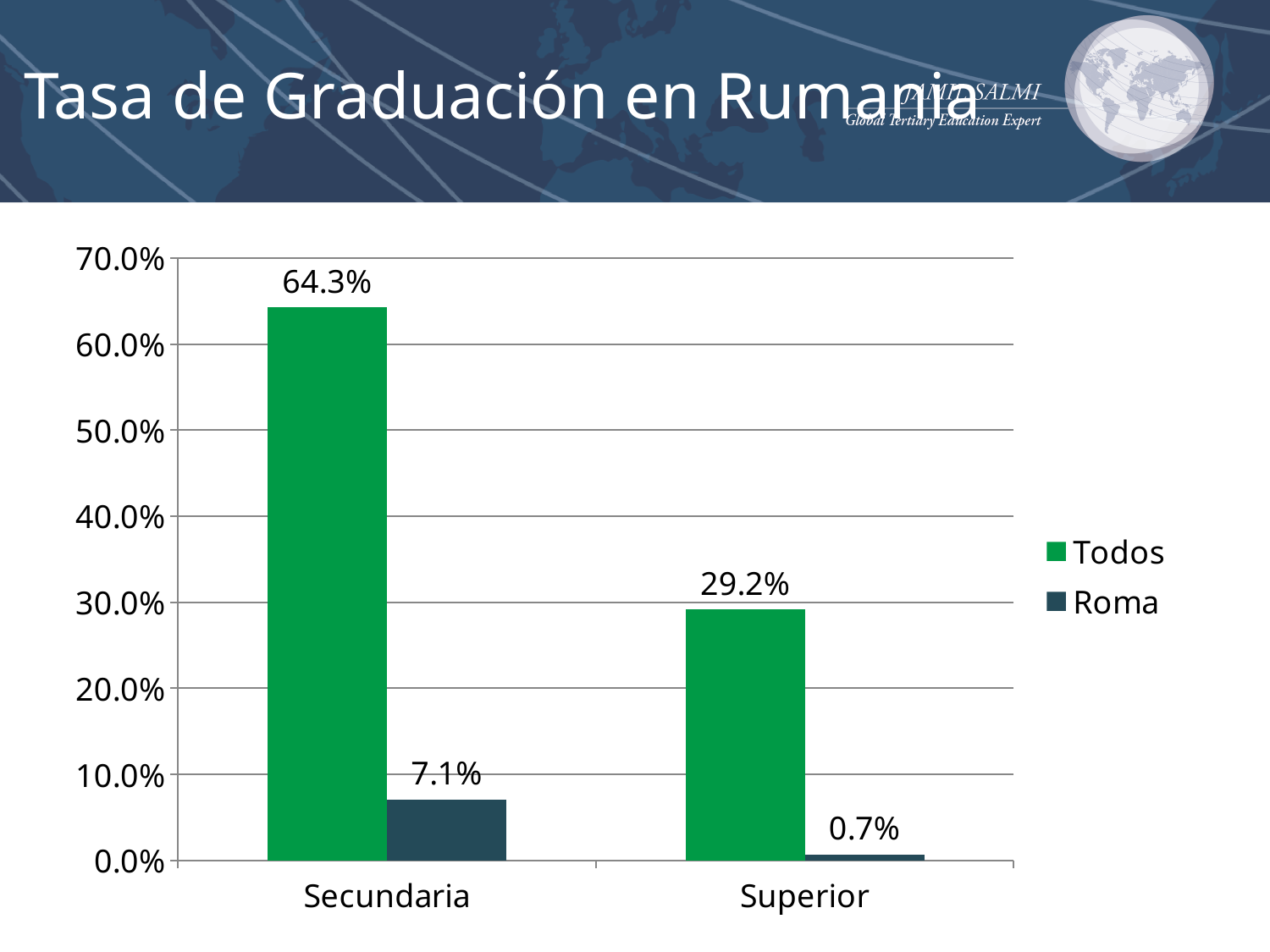
What is the title of the slide containing the chart? Tasa de Graduación en Rumania Which category has the lowest value for the Roma series? Superior What is the value for Todos in the Secundaria category? 64.3% Which category has the highest value for the Todos series? Secundaria What is the difference between the Todos and Roma values in the Secundaria category? 57.2% How many series does the legend list? 2 What is the difference between the Todos values for Secundaria and Superior? 35.1% What is the value for Roma in the Secundaria category? 7.1% What is the value for Roma in the Superior category? 0.7% What is the value for Todos in the Superior category? 29.2% Which is larger: the Roma value for Secundaria or the Todos value for Superior? Todos value for Superior What kind of chart is shown on the slide? Bar chart